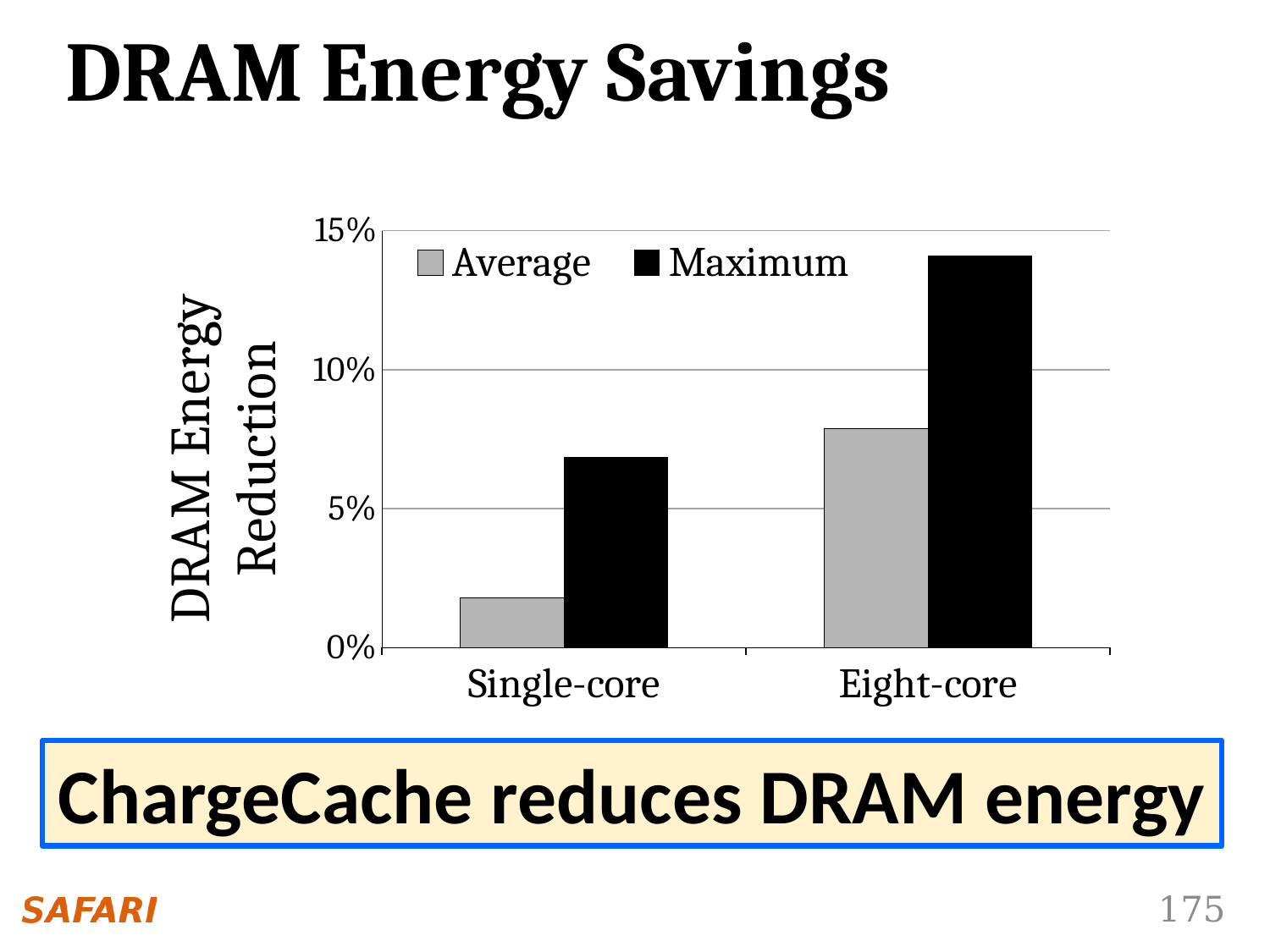
What is the label on the y axis of the chart? DRAM Energy Reduction Which is larger, the Maximum value for Single-core or the Maximum value for Eight-core? Eight-core Is the Average value for Single-core greater or less than 5%? less Is the Maximum value for Eight-core greater or less than 10%? greater Is the Average value for Eight-core greater or less than 10%? less Which bar is the tallest in the chart? Maximum for Eight-core How many series does the legend list? 2 Which bar is the shortest in the chart? Average for Single-core How many categories are shown on the x axis? 2 What kind of chart is shown on the slide? bar chart Do the values rise or fall going from Single-core to Eight-core? rise